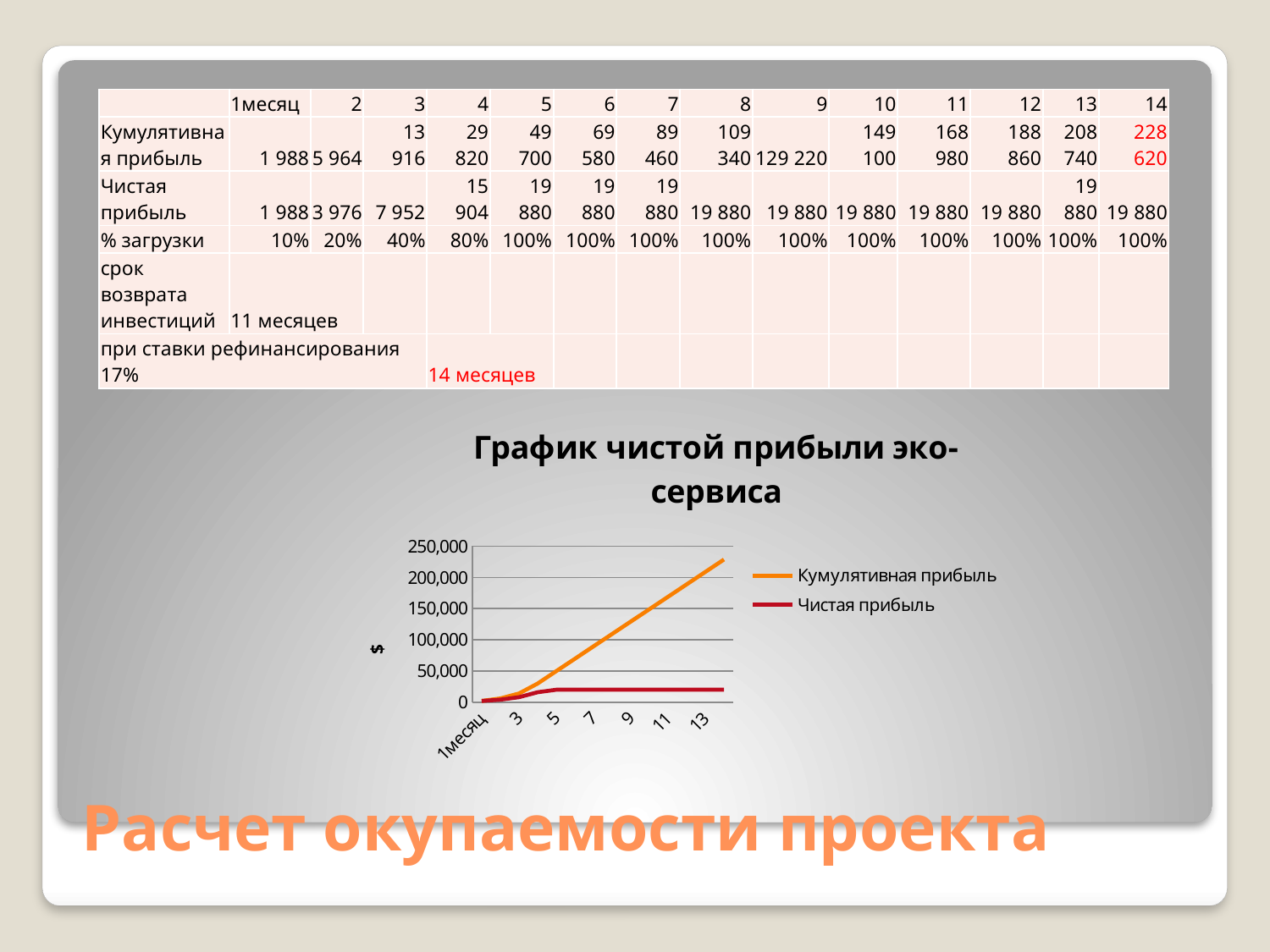
What label is shown on the vertical axis of the chart? $ How many series does the chart legend list? 2 Is the value of Кумулятивная прибыль at month 9 greater or less than 100,000? greater Is the value of Чистая прибыль at month 13 greater or less than 50,000? less Is the value of Кумулятивная прибыль at month 13 greater or less than 200,000? greater At month 13, which series has the larger value, Кумулятивная прибыль or Чистая прибыль? Кумулятивная прибыль What kind of chart is shown on the slide? line chart What is the title of the chart? График чистой прибыли эко-сервиса Which series reaches the highest value on the chart? Кумулятивная прибыль Does the Кумулятивная прибыль line rise or fall from 1месяц to month 13? rise